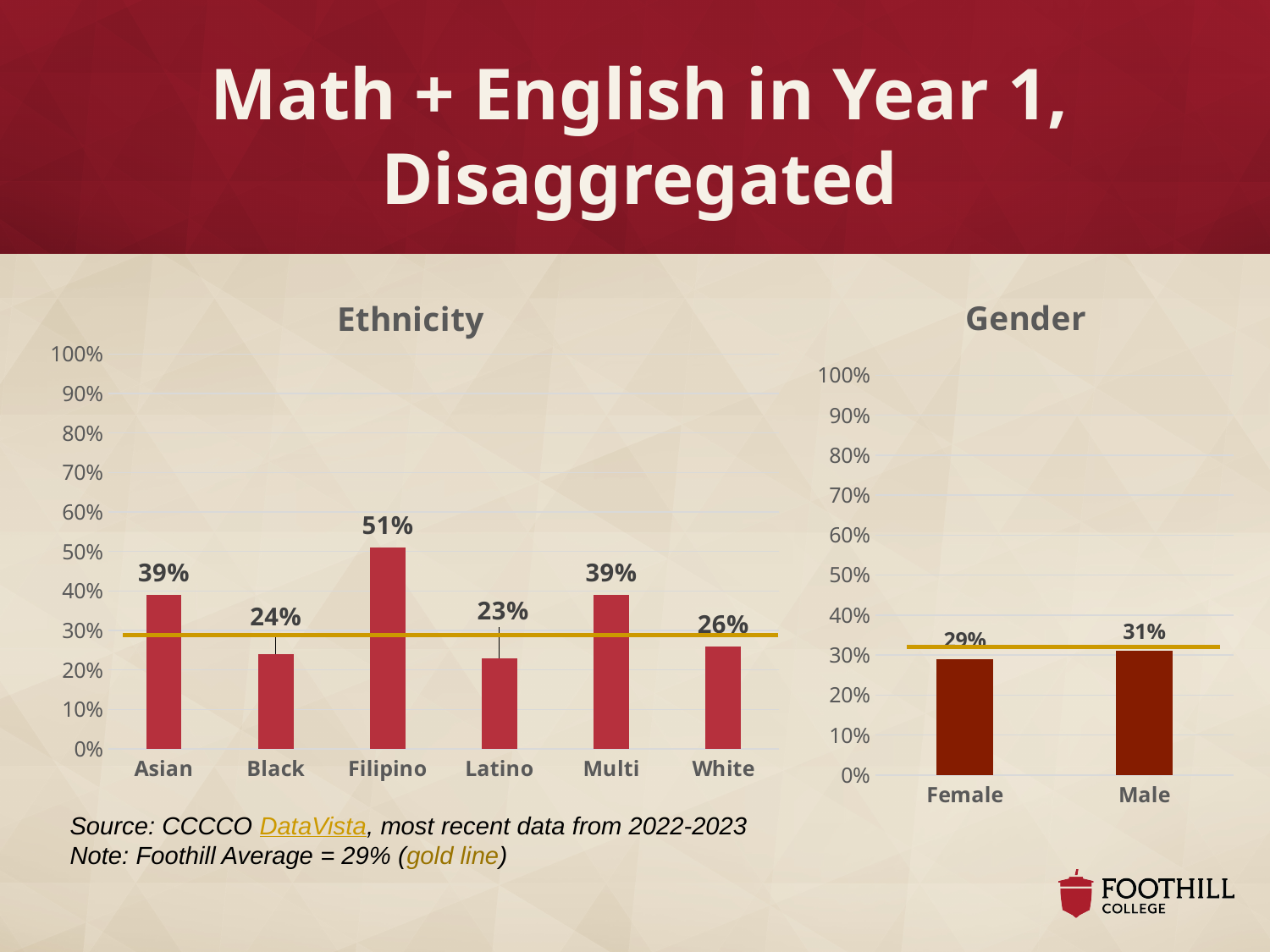
In the Gender chart, what is the value for Female? 29% According to the note on the slide, what value does the gold line represent? Foothill Average = 29% In the Gender chart, which category has the higher value? Male In the Ethnicity chart, what is the difference between the values for Filipino and Black? 27% In the Ethnicity chart, how many categories are shown on the x axis? 6 In the Gender chart, what is the value for Male? 31% In the Ethnicity chart, which is larger, the value for White or the value for Black? White In the Ethnicity chart, which category has the highest value? Filipino In the Ethnicity chart, what is the value for Latino? 23% In the Ethnicity chart, which category has the lowest value? Latino What kind of chart is the Gender chart? Bar chart In the Ethnicity chart, what is the value for Filipino? 51%